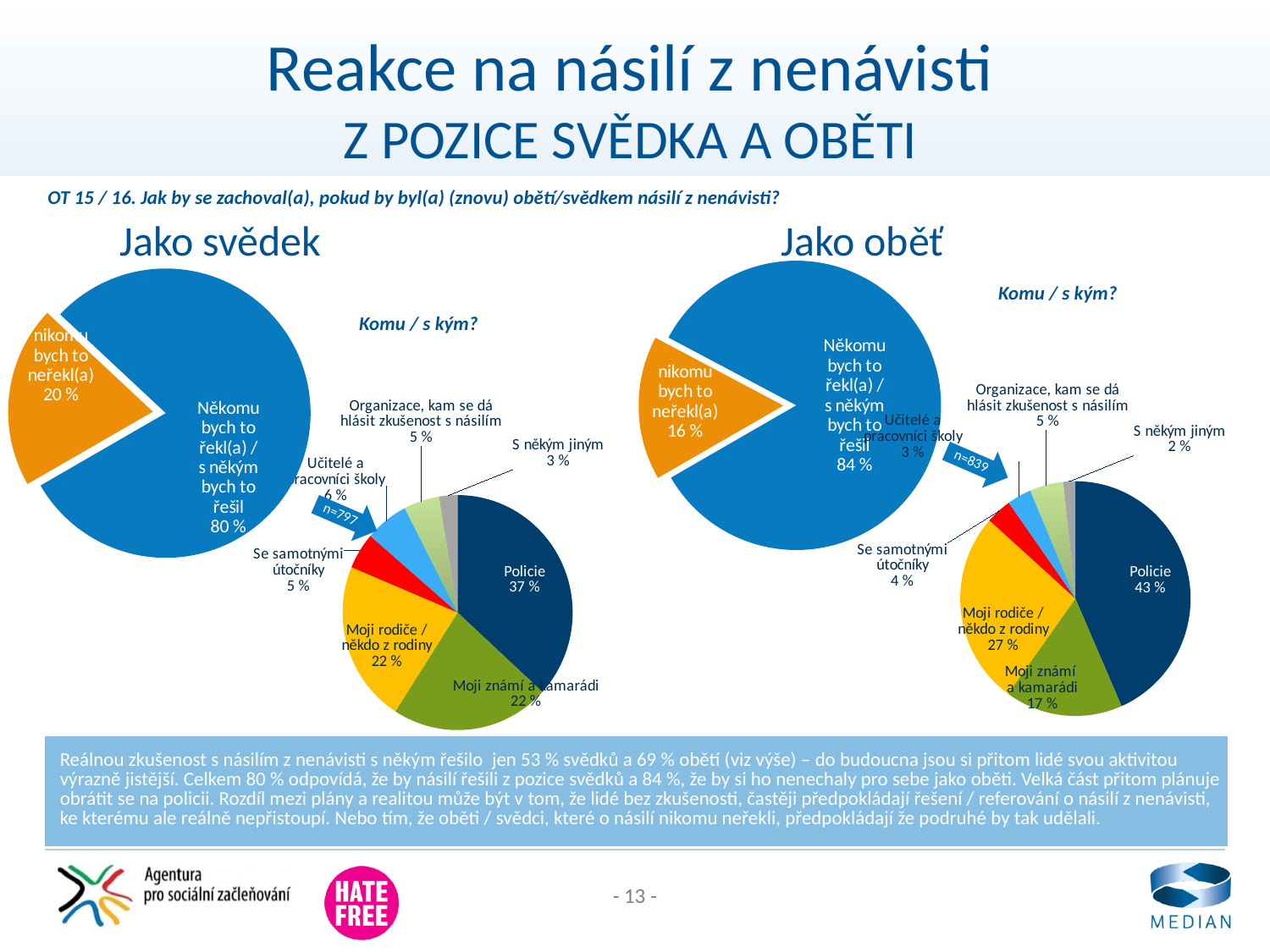
What is the difference between the Policie share in the 'Jako oběť' Komu / s kým? chart and the Policie share in the 'Jako svědek' Komu / s kým? chart? 6 % In the 'Komu / s kým?' pie chart under 'Jako svědek', which category has the smallest share? S někým jiným What sample size (n) is shown next to the 'Komu / s kým?' chart under 'Jako oběť'? n=839 How many categories are shown in the 'Komu / s kým?' pie chart under 'Jako svědek'? 7 In the 'Jako oběť' pie chart, what share of respondents would tell no one (nikomu bych to neřekl(a))? 16 % What is the difference between the 'Někomu bych to řekl(a)' share in the 'Jako oběť' chart and in the 'Jako svědek' chart? 4 % What type of chart is used for 'Jako svědek' and 'Jako oběť'? Pie chart In the 'Jako svědek' pie chart, what share of respondents would tell someone (Někomu bych to řekl(a))? 80 % In the 'Komu / s kým?' pie chart under 'Jako oběť', which category has the largest share? Policie In the 'Komu / s kým?' pie chart under 'Jako oběť', what is the value for Moji rodiče / někdo z rodiny? 27 % In the 'Komu / s kým?' pie chart under 'Jako svědek', what is the value for Policie? 37 % In the 'Komu / s kým?' pie chart under 'Jako oběť', which is larger: Moji rodiče / někdo z rodiny or Moji známí a kamarádi? Moji rodiče / někdo z rodiny